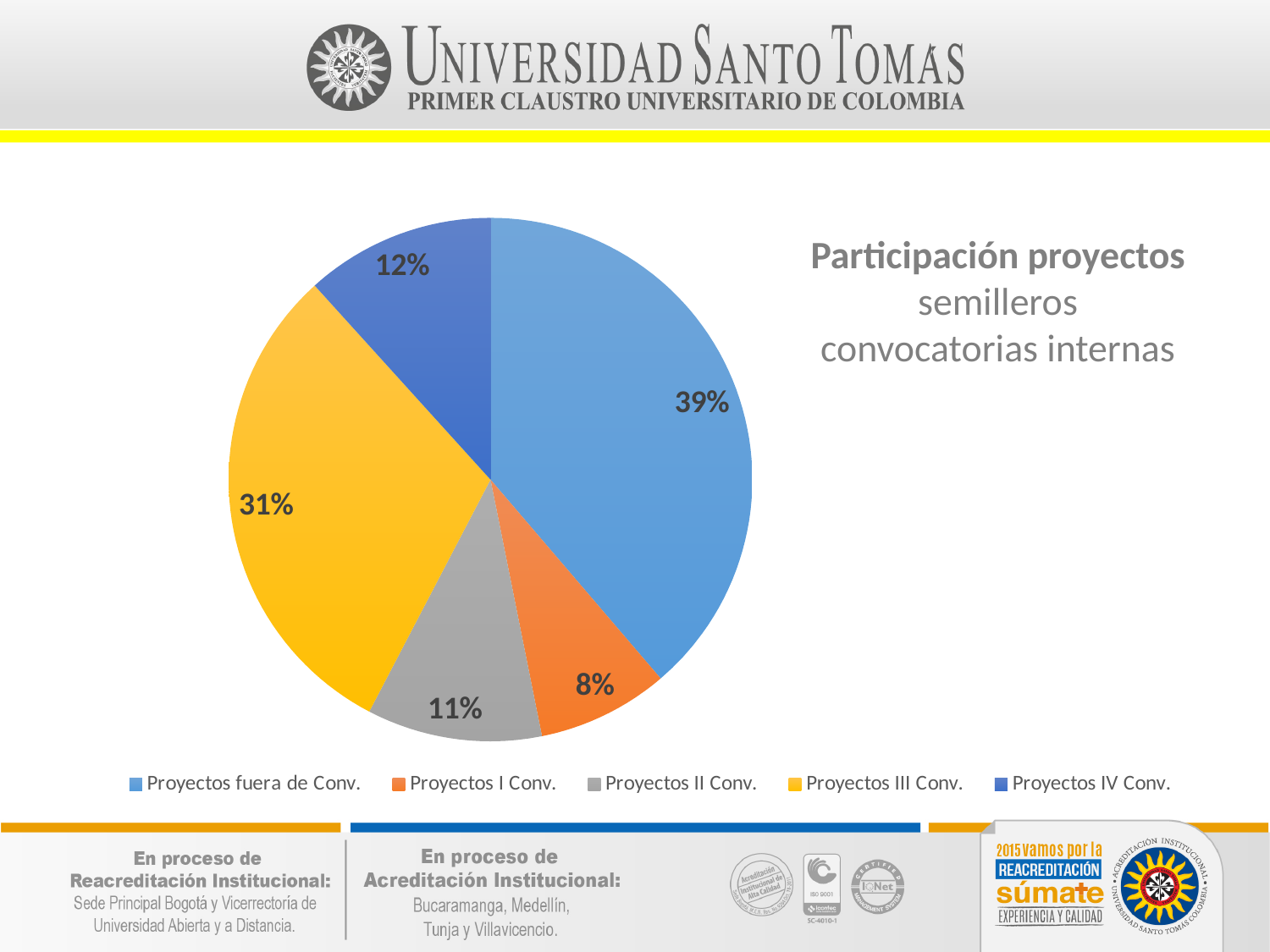
Which category has the largest slice of the pie? Proyectos fuera de Conv. What share of the pie does Proyectos III Conv. represent? 31% How many categories does the pie chart show? 5 Which category has the smallest slice of the pie? Proyectos I Conv. What is the value shown for Proyectos IV Conv.? 12% Which is larger, Proyectos II Conv. or Proyectos IV Conv.? Proyectos IV Conv. Which category is shown in yellow in the pie chart? Proyectos III Conv. What is the title of the chart? Participación proyectos semilleros convocatorias internas What kind of chart is shown on the slide? Pie chart What is the difference in percentage points between Proyectos fuera de Conv. and Proyectos III Conv.? 8 What is the value shown for Proyectos I Conv.? 8% What share of the pie does Proyectos fuera de Conv. represent? 39%